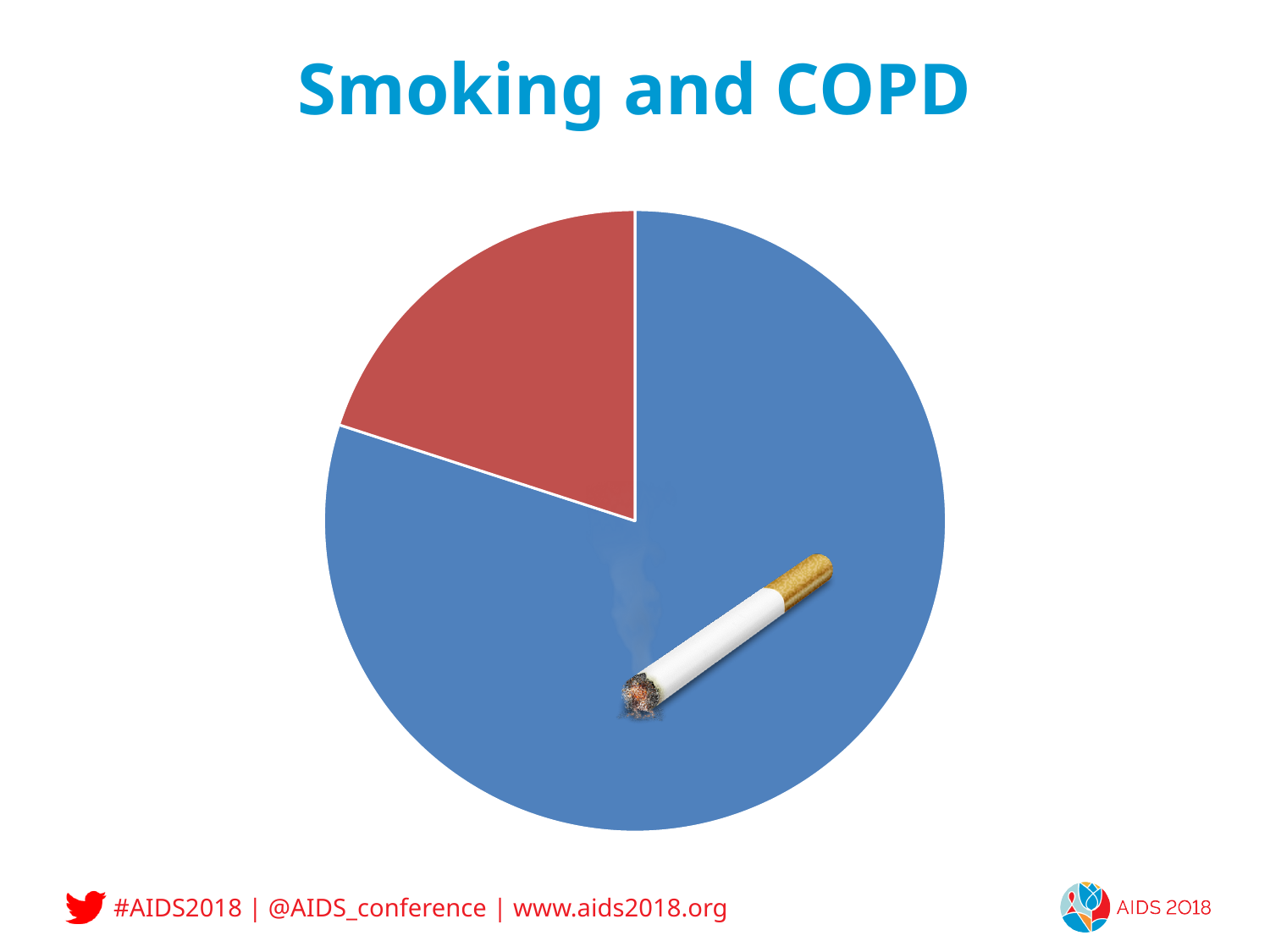
How many slices does the pie chart have? 2 Which colour slice takes up the largest share of the pie chart? blue Which slice of the pie chart is larger, the blue one or the red one? the blue one What kind of chart is shown on the slide? pie chart What is the title of the slide containing the pie chart? Smoking and COPD Which colour slice takes up the smallest share of the pie chart? red Does the pie chart display a legend? No